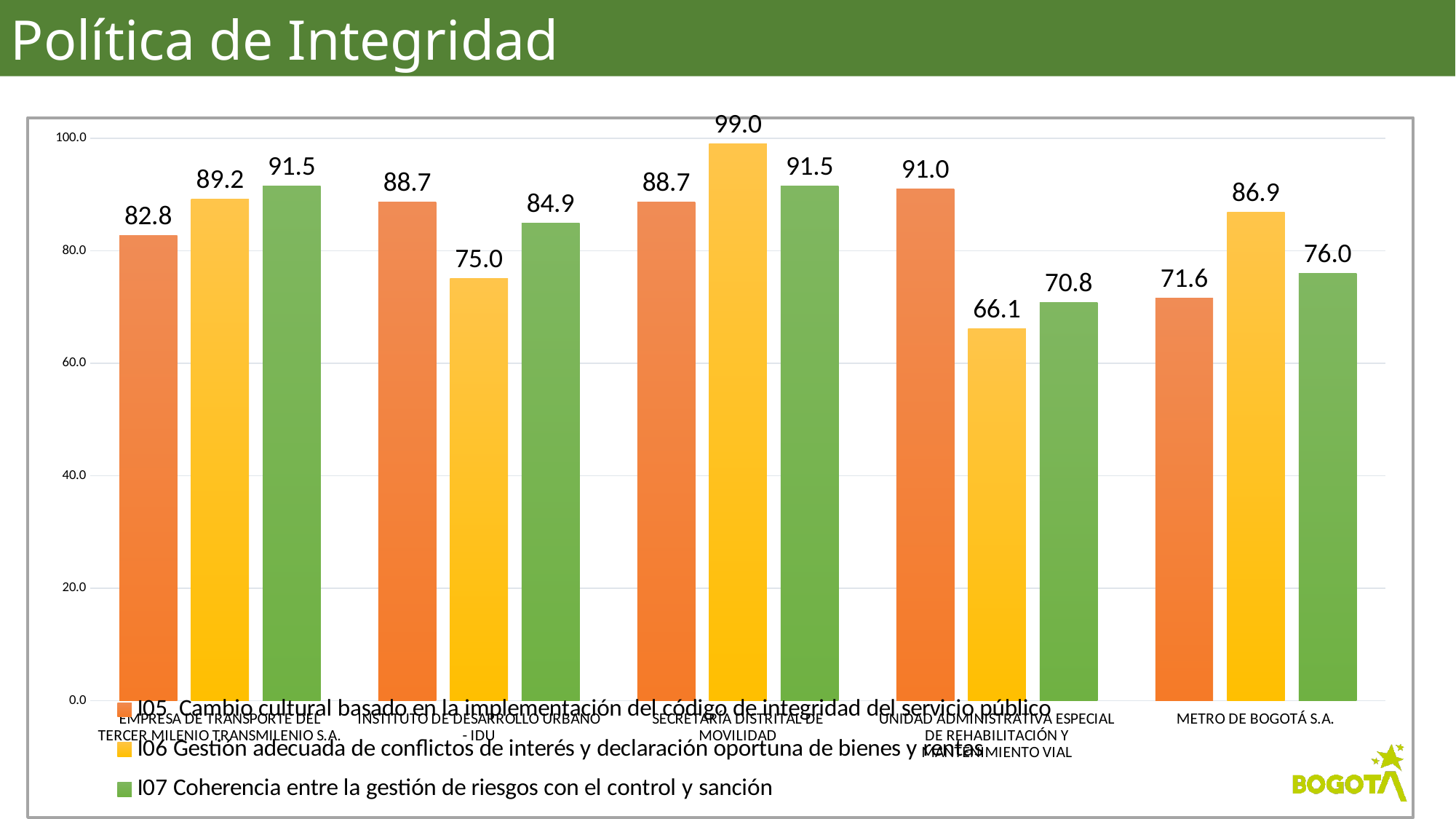
What kind of chart is shown on the slide? bar chart What is the I07 value for METRO DE BOGOTÁ S.A.? 76.0 What is the title of the slide? Política de Integridad Which entity has the lowest I06 value? UNIDAD ADMINISTRATIVA ESPECIAL DE REHABILITACIÓN Y MANTENIMIENTO VIAL How many entities are shown on the x axis of the chart? 5 Which is larger for METRO DE BOGOTÁ S.A., the I05 value or the I06 value? I06 Which entity has the highest I05 value? UNIDAD ADMINISTRATIVA ESPECIAL DE REHABILITACIÓN Y MANTENIMIENTO VIAL What is the difference between the I06 and I07 values for INSTITUTO DE DESARROLLO URBANO - IDU? 9.9 What is the I06 value for SECRETARÍA DISTRITAL DE MOVILIDAD? 99.0 What is the I05 value for INSTITUTO DE DESARROLLO URBANO - IDU? 88.7 How many series does the legend list? 3 Is the I07 value for UNIDAD ADMINISTRATIVA ESPECIAL DE REHABILITACIÓN Y MANTENIMIENTO VIAL greater or less than 80.0? less